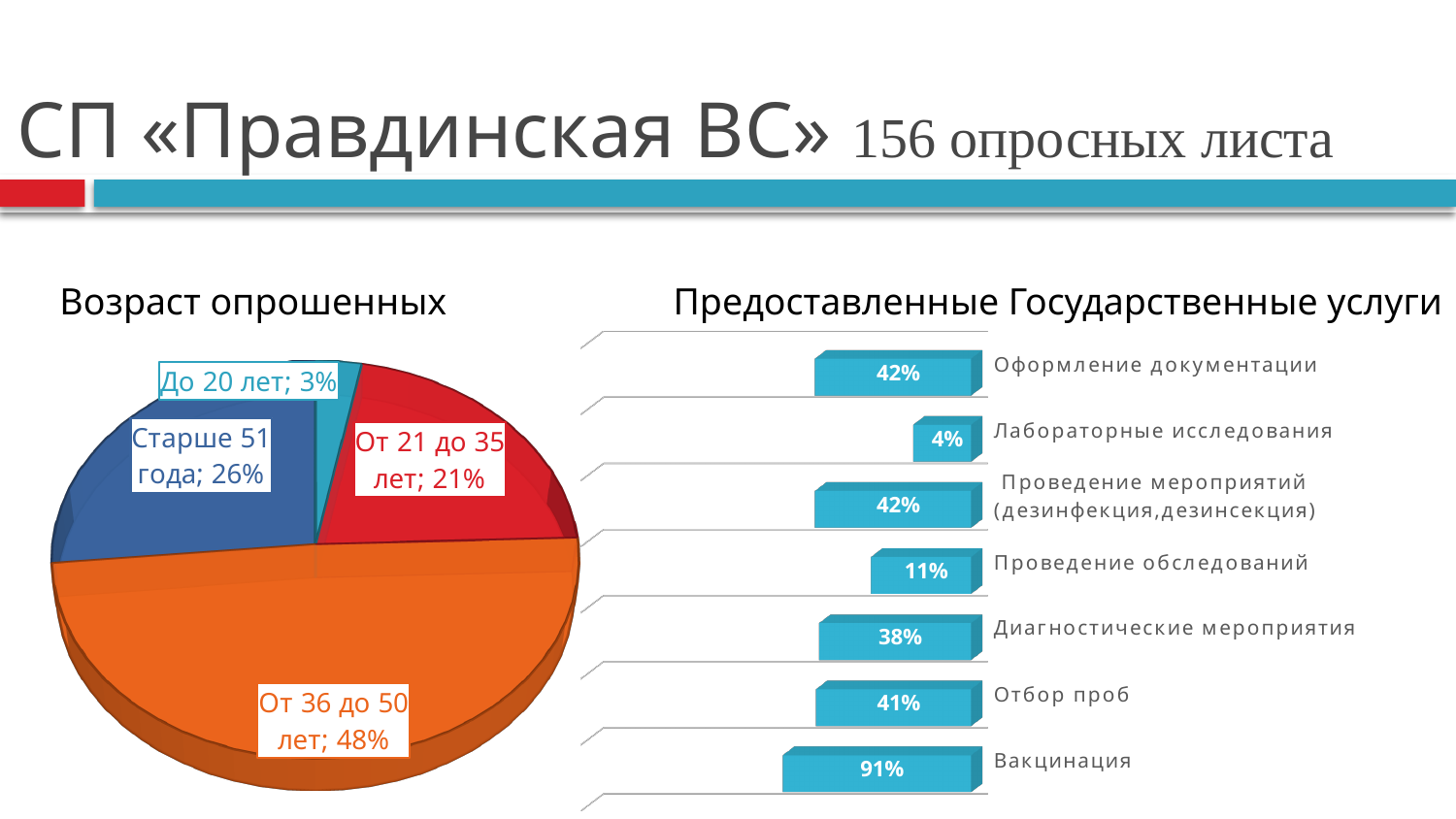
In the chart titled «Предоставленные Государственные услуги», what is the value for «Проведение обследований»? 11% In the chart titled «Предоставленные Государственные услуги», how many services are listed? 7 In the chart titled «Предоставленные Государственные услуги», what is the difference between «Вакцинация» and «Отбор проб»? 50% In the chart titled «Предоставленные Государственные услуги», which service has the lowest value? Лабораторные исследования In the chart titled «Предоставленные Государственные услуги», which service has the highest value? Вакцинация What kind of chart is the one titled «Возраст опрошенных»? Pie chart In the chart titled «Предоставленные Государственные услуги», what is the value for «Вакцинация»? 91% In the chart titled «Возраст опрошенных», which age group has the smallest share? До 20 лет In the chart titled «Возраст опрошенных», how many age groups are shown? 4 In the chart titled «Возраст опрошенных», what share of respondents are «Старше 51 года»? 26% In the chart titled «Возраст опрошенных», which age group has the largest share? От 36 до 50 лет In the chart titled «Возраст опрошенных», what share of respondents are «От 36 до 50 лет»? 48%